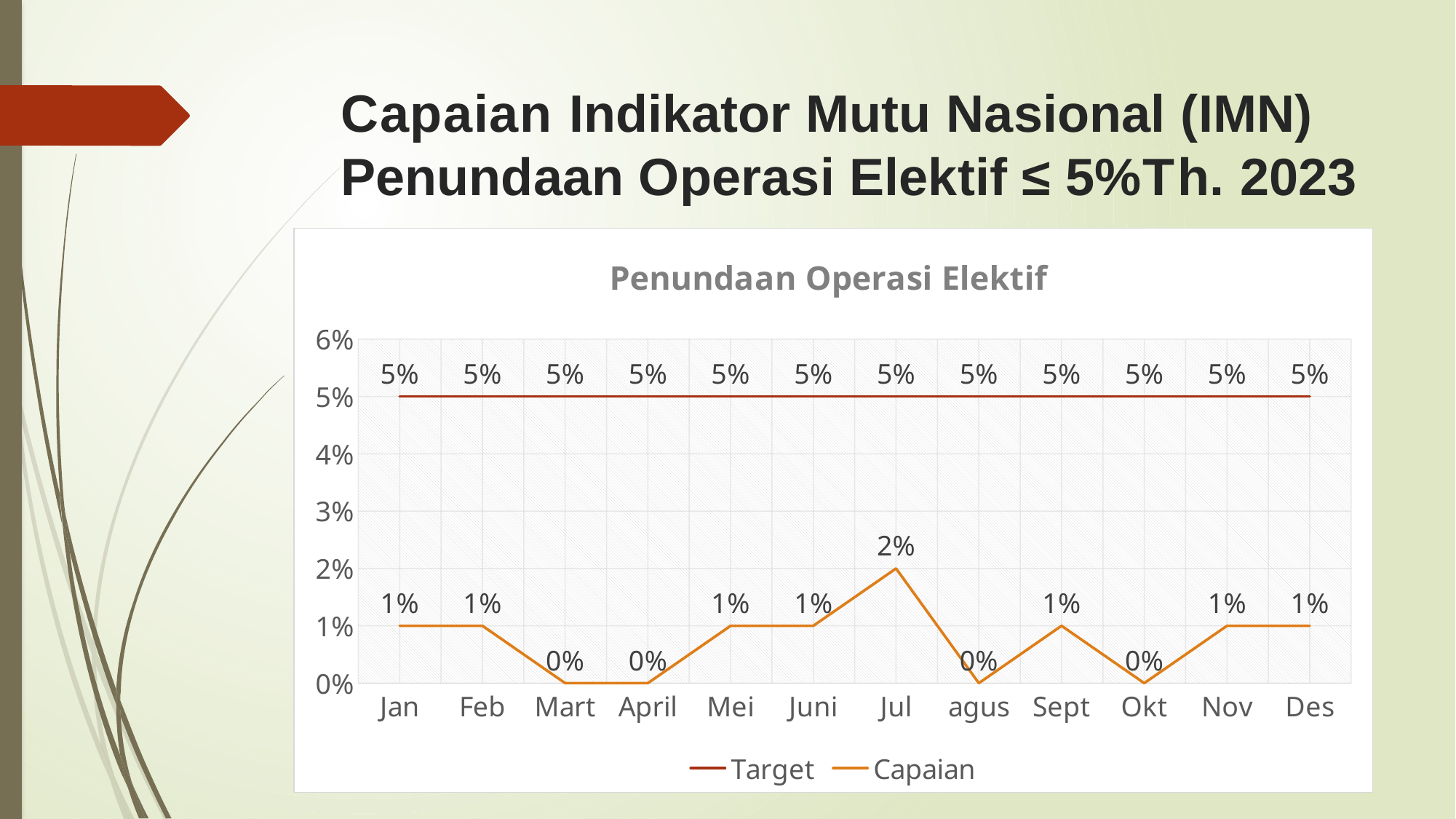
What kind of chart is shown? line chart Does the Capaian value rise or fall from Juni to Jul? rise What is the Capaian value for Jul? 2% What is the title of the chart? Penundaan Operasi Elektif Which month has the highest Capaian value? Jul Which is larger, the Capaian value for Jul or the Capaian value for Sept? Jul What is the Capaian value for Mart? 0% What are the two series listed in the legend? Target and Capaian How many months are shown on the x axis? 12 What is the Target value for Mei? 5% What is the difference between the Target and Capaian values for Jul? 3% How many series does the legend list? 2